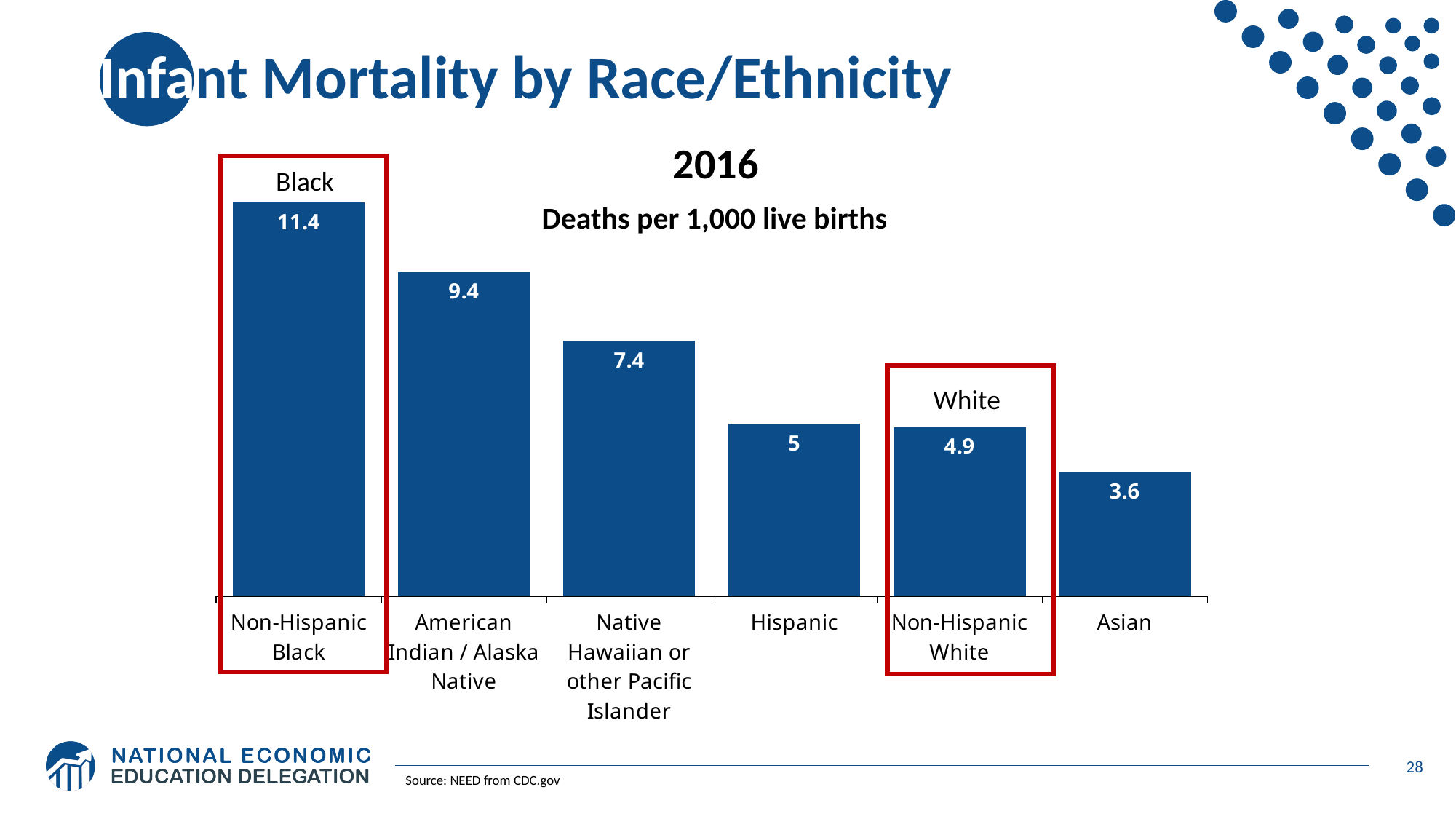
What is the value shown for Asian? 3.6 What unit is the chart measured in, according to the subtitle? Deaths per 1,000 live births Which category has the lowest infant mortality rate? Asian Which category has the highest infant mortality rate? Non-Hispanic Black How many categories are shown in the chart? 6 What is the value shown for Native Hawaiian or other Pacific Islander? 7.4 Which is larger, the value for Hispanic or the value for Non-Hispanic White? Hispanic What kind of chart is shown on the slide? Bar chart What is the difference between the Non-Hispanic Black and Non-Hispanic White values? 6.5 What is the infant mortality rate for Non-Hispanic Black? 11.4 What is the value shown for Hispanic? 5 What is the value shown for American Indian / Alaska Native? 9.4